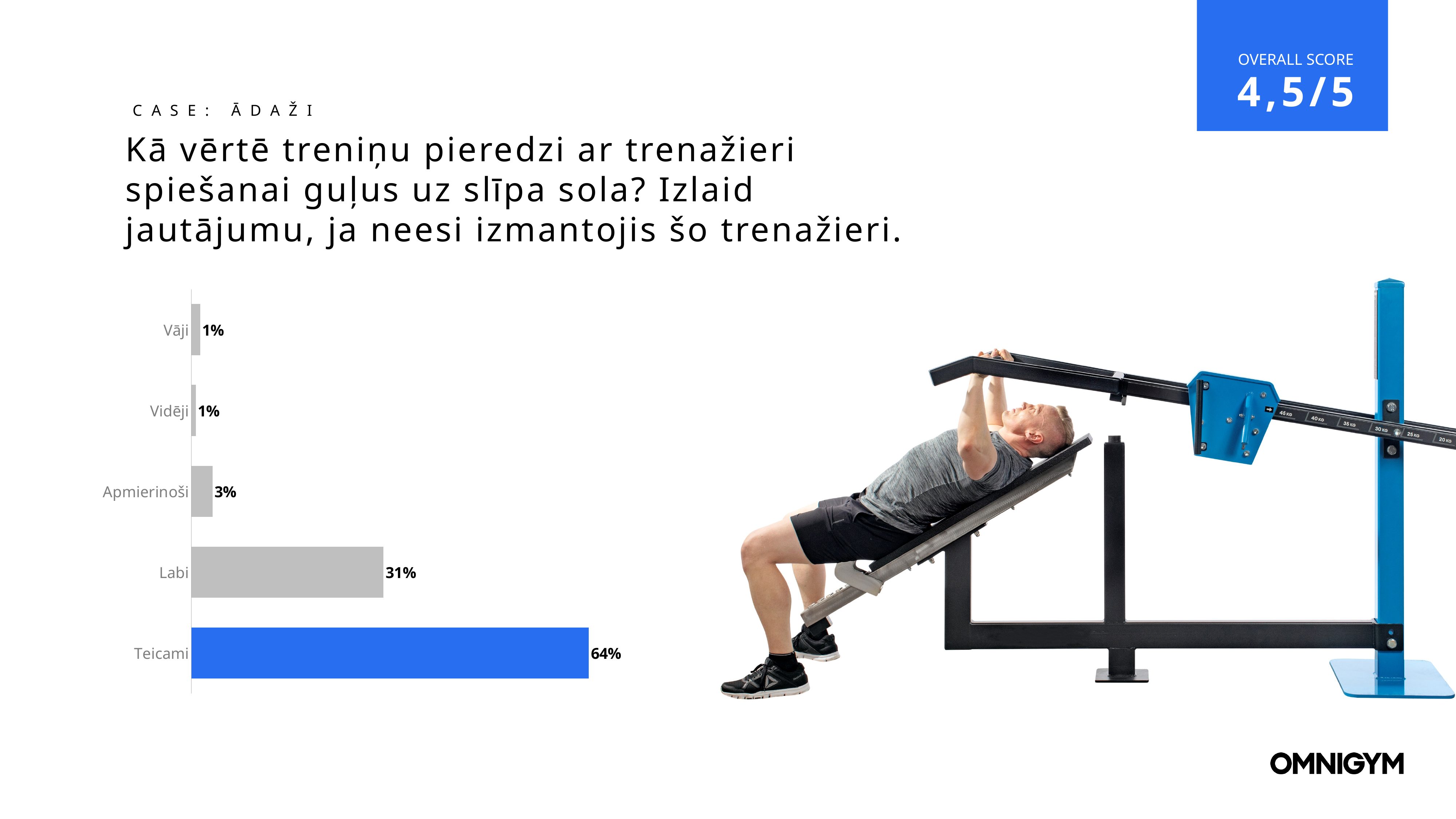
What is the difference between the values for Teicami and Labi? 33% What is the difference between the values for Apmierinoši and Vidēji? 2% Which is larger, the value for Labi or the value for Apmierinoši? Labi How many categories are shown in the chart? 5 What is the value for Apmierinoši? 3% What is the value for Vāji? 1% What is the value for Labi? 31% Which category has the highest value? Teicami What is the value for Teicami? 64% Which bar in the chart is coloured blue rather than grey? Teicami What overall score is shown on the slide? 4,5/5 What kind of chart is shown on the slide? Bar chart